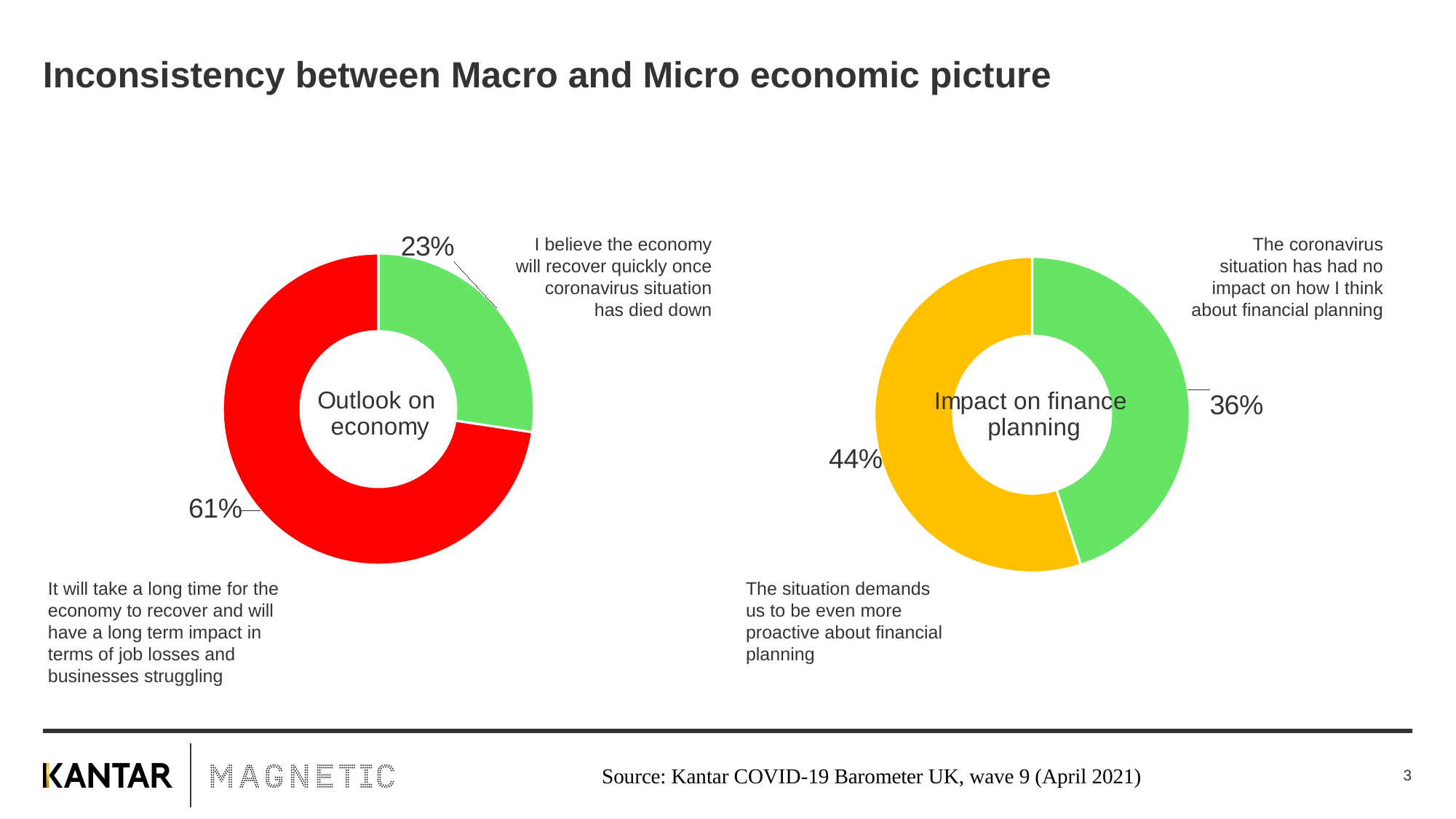
In the 'Impact on finance planning' chart, what is the difference in percentage points between the 44% and 36% segments? 8 percentage points In the 'Impact on finance planning' chart, which response has the smaller share? The coronavirus situation has had no impact on how I think about financial planning How many charts are shown on the slide? 2 What type of chart is used for 'Outlook on economy'? Donut (pie) chart In the 'Outlook on economy' chart, what percentage say it will take a long time for the economy to recover? 61% Is the 'no impact on financial planning' value in the right chart larger or smaller than the 'recover quickly' value in the left chart? larger In the 'Impact on finance planning' chart, what percentage say the coronavirus situation has had no impact on how they think about financial planning? 36% In the 'Impact on finance planning' chart, what percentage say the situation demands them to be even more proactive about financial planning? 44% In the 'Outlook on economy' chart, what is the difference in percentage points between the 61% and 23% segments? 38 percentage points In the 'Outlook on economy' chart, what colour is the 61% segment? Red In the 'Outlook on economy' chart, what percentage of respondents believe the economy will recover quickly once the coronavirus situation has died down? 23% In the 'Outlook on economy' chart, which response has the larger share? It will take a long time for the economy to recover